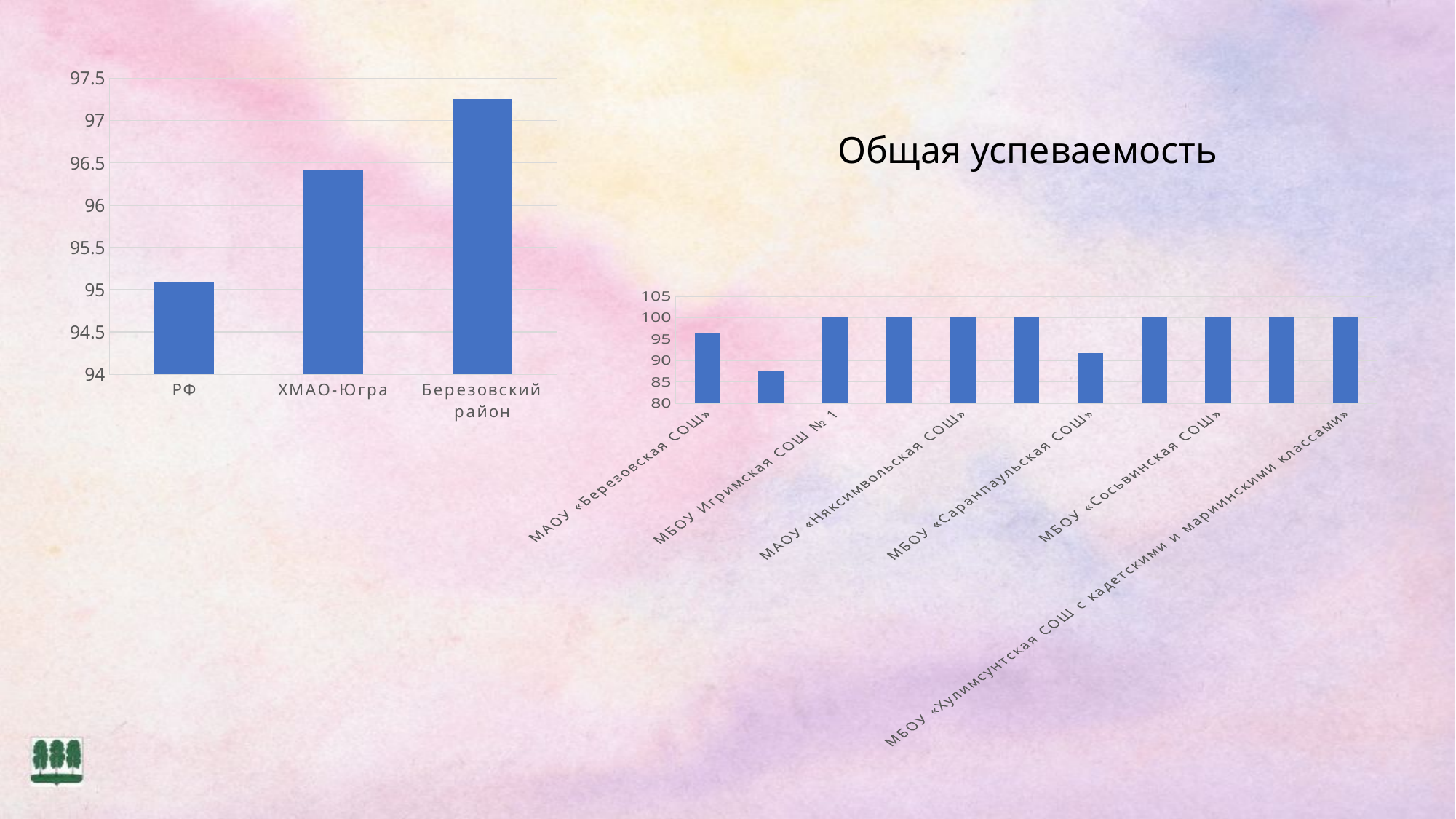
How many bars are plotted in the chart on the right of the slide? 11 In the chart on the right of the slide, is the value for МБОУ «Саранпаульская СОШ» greater or less than 95? less How many categories are shown in the chart on the left of the slide? 3 In the chart on the left of the slide, is the value for Березовский район greater or less than 97? greater In the chart on the left of the slide, which category has the lowest value? РФ In the chart on the left of the slide, is the value for РФ greater or less than 95.5? less What kind of chart is the chart on the left of the slide? bar chart In the chart on the left of the slide, which is larger: the value for РФ or the value for ХМАО-Югра? ХМАО-Югра In the chart on the left of the slide, which category has the highest value? Березовский район In the chart on the left of the slide, do the values rise or fall from left to right along the x axis? rise